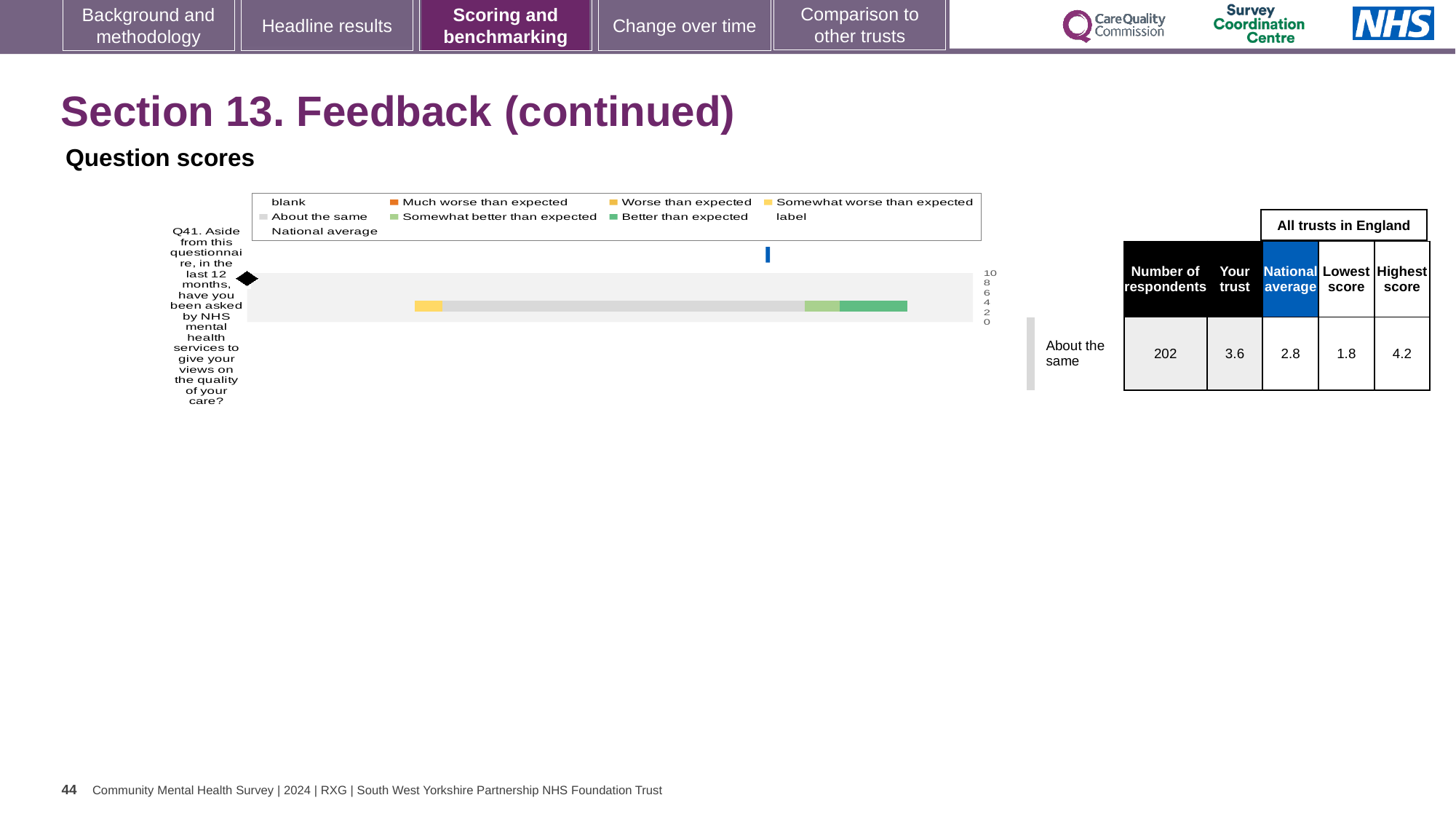
What colour does the legend use for 'Better than expected'? green How many respondents answered Q41? 202 Which benchmark category is Q41 assigned to on this slide? About the same What is the national average score for Q41? 2.8 By how much does the 'Your trust' score for Q41 exceed the national average? 0.8 What is the lowest score among all trusts in England for Q41? 1.8 What kind of chart is shown for Q41 on the slide? bar chart What is the difference between the highest and lowest trust scores for Q41? 2.4 Which is larger for Q41, the 'Your trust' score or the national average? Your trust What is the highest score among all trusts in England for Q41? 4.2 What is the 'Your trust' score for Q41? 3.6 How many survey questions are plotted in the chart on this slide? 1